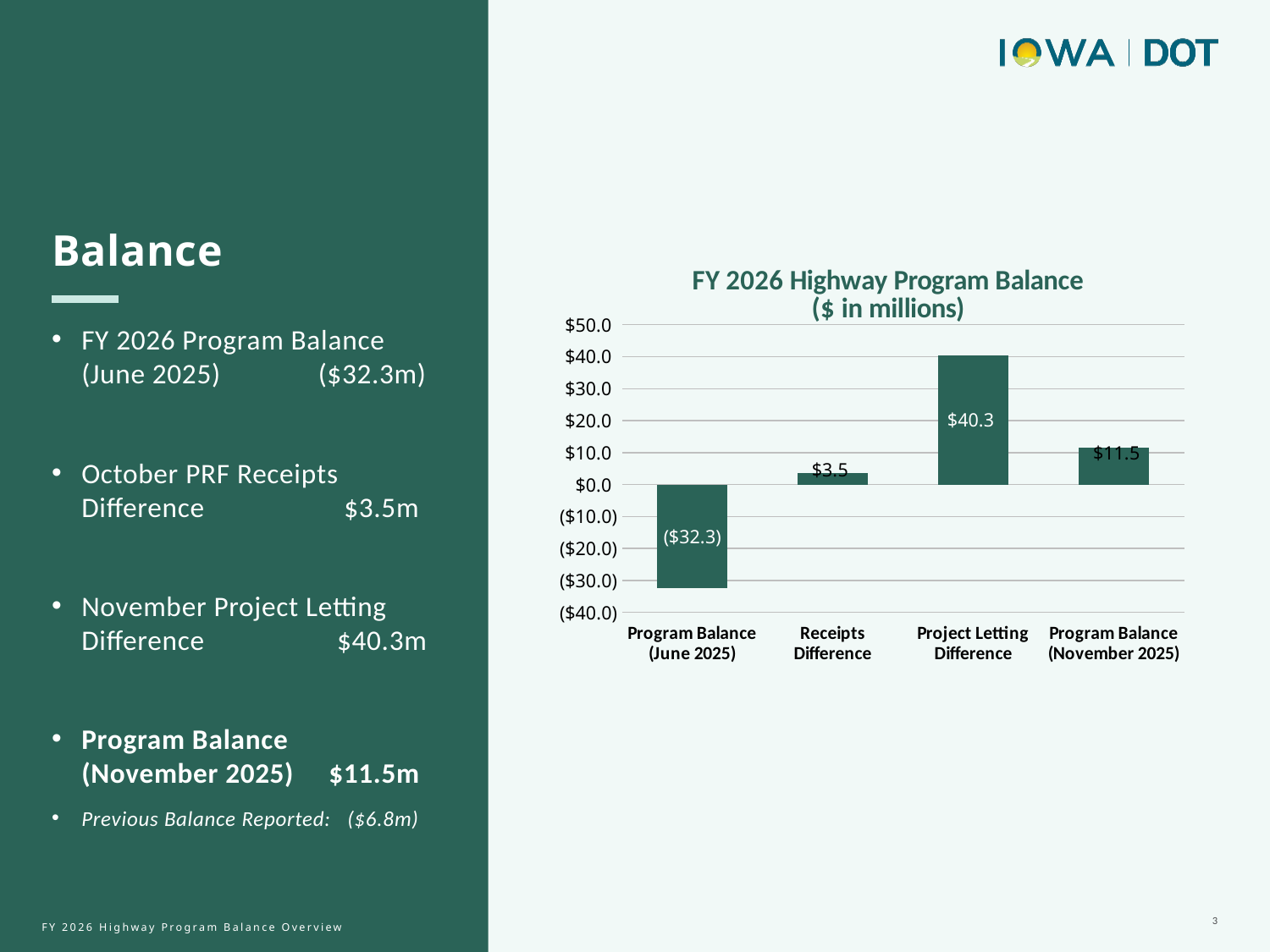
Which is larger, Receipts Difference or Program Balance (November 2025)? Program Balance (November 2025) What is the value for Project Letting Difference? $40.3 What is the title of the chart? FY 2026 Highway Program Balance ($ in millions) What is the difference between Project Letting Difference and Program Balance (November 2025)? $28.8 What kind of chart is shown? Bar chart What is the value for Receipts Difference? $3.5 What is the value for Program Balance (June 2025)? ($32.3) How many categories are shown on the x axis? 4 Which category has the lowest value? Program Balance (June 2025) What is the value for Program Balance (November 2025)? $11.5 Is the value for Project Letting Difference greater or less than $30.0? greater Which category has the highest value? Project Letting Difference